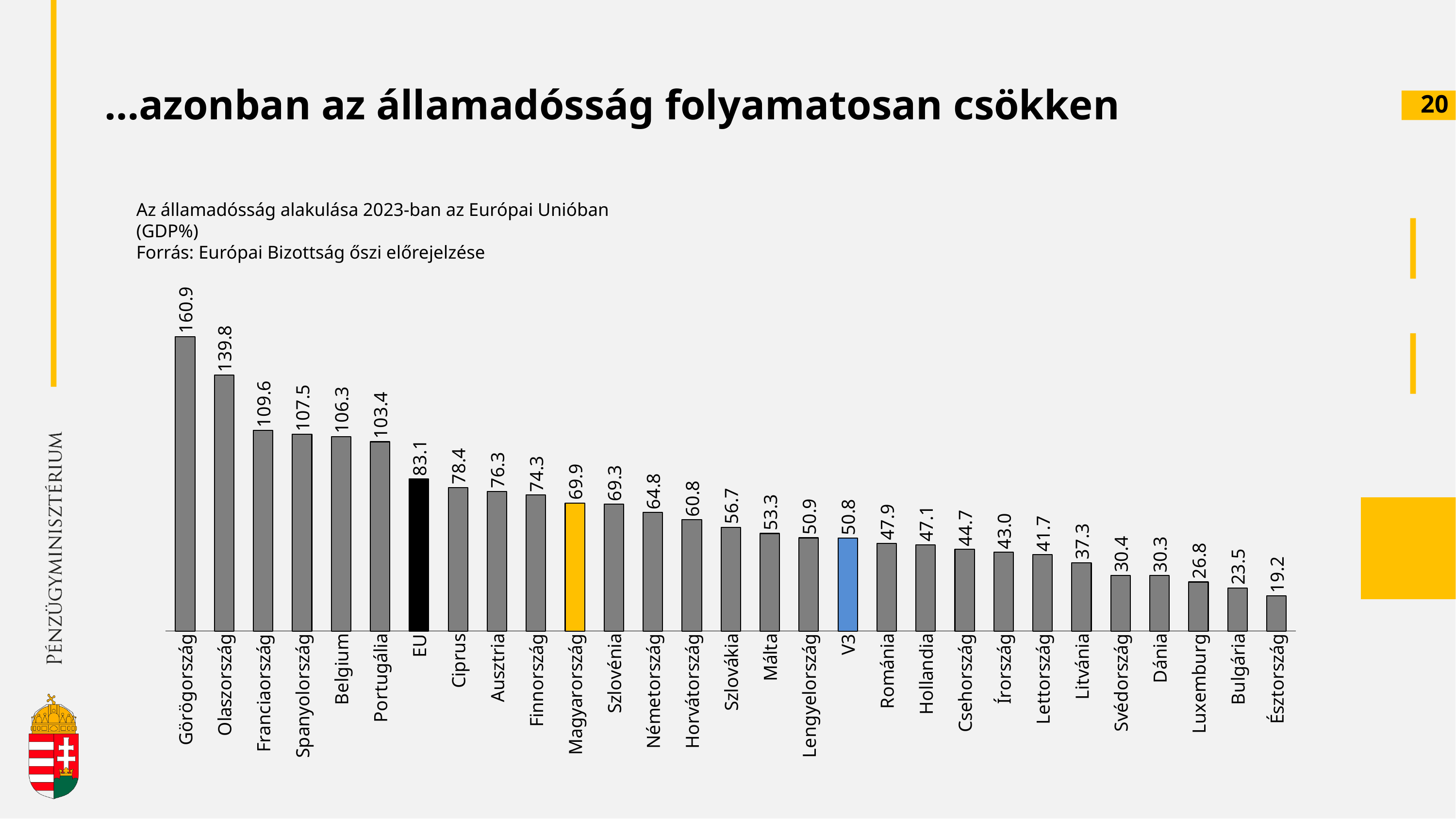
What is the difference between the EU value and the Magyarország value? 13.2 Do the values rise or fall from left to right along the x axis? Fall How many bars are shown in the chart? 29 What colour is the bar for Magyarország? Yellow Which category has the lowest value? Észtország Which category has the highest value? Görögország What is the value for the EU bar? 83.1 What kind of chart is shown on the slide? Bar chart Which is larger, the value for Németország or the value for Horvátország? Németország What is the value for V3? 50.8 What is the difference between the values for Görögország and Olaszország? 21.1 What is the value for Magyarország? 69.9